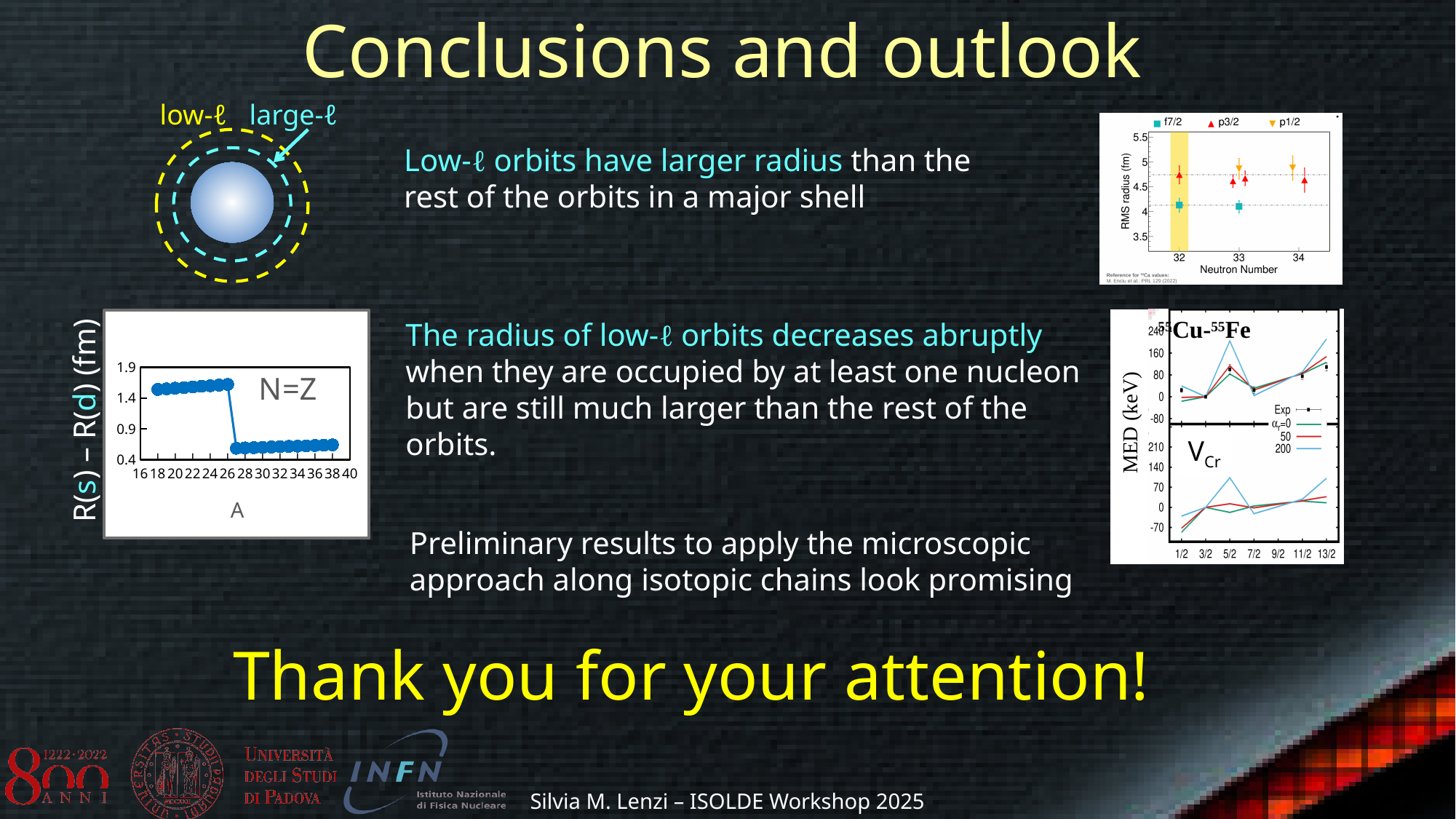
In the chart on the left with A on the x axis, do the plotted values rise or fall as A increases? fall In the bottom-right MED chart, how many spin values are labelled on the x axis? 7 In the chart on the left with A on the x axis, what text annotation is printed inside the plot area? N=Z In the chart on the left with A on the x axis, which is larger, the value at A = 24 or the value at A = 34? A = 24 In the top-right chart of RMS radius versus Neutron Number, how many series does the legend list? 3 In the chart on the left with A on the x axis, is the value at A = 30 greater or less than 0.9? less In the chart on the left with A on the x axis, is the value at A = 20 greater or less than 1.4? greater In the chart on the left with A on the x axis, what is the label of the y axis? R(s) – R(d) (fm) In the top-right chart of RMS radius versus Neutron Number, is the f7/2 value at neutron number 32 greater or less than 4.5? less In the top-right chart of RMS radius versus Neutron Number, which series has the larger value at neutron number 32, p3/2 or f7/2? p3/2 In the top-right chart of RMS radius versus Neutron Number, how many neutron numbers are labelled on the x axis? 3